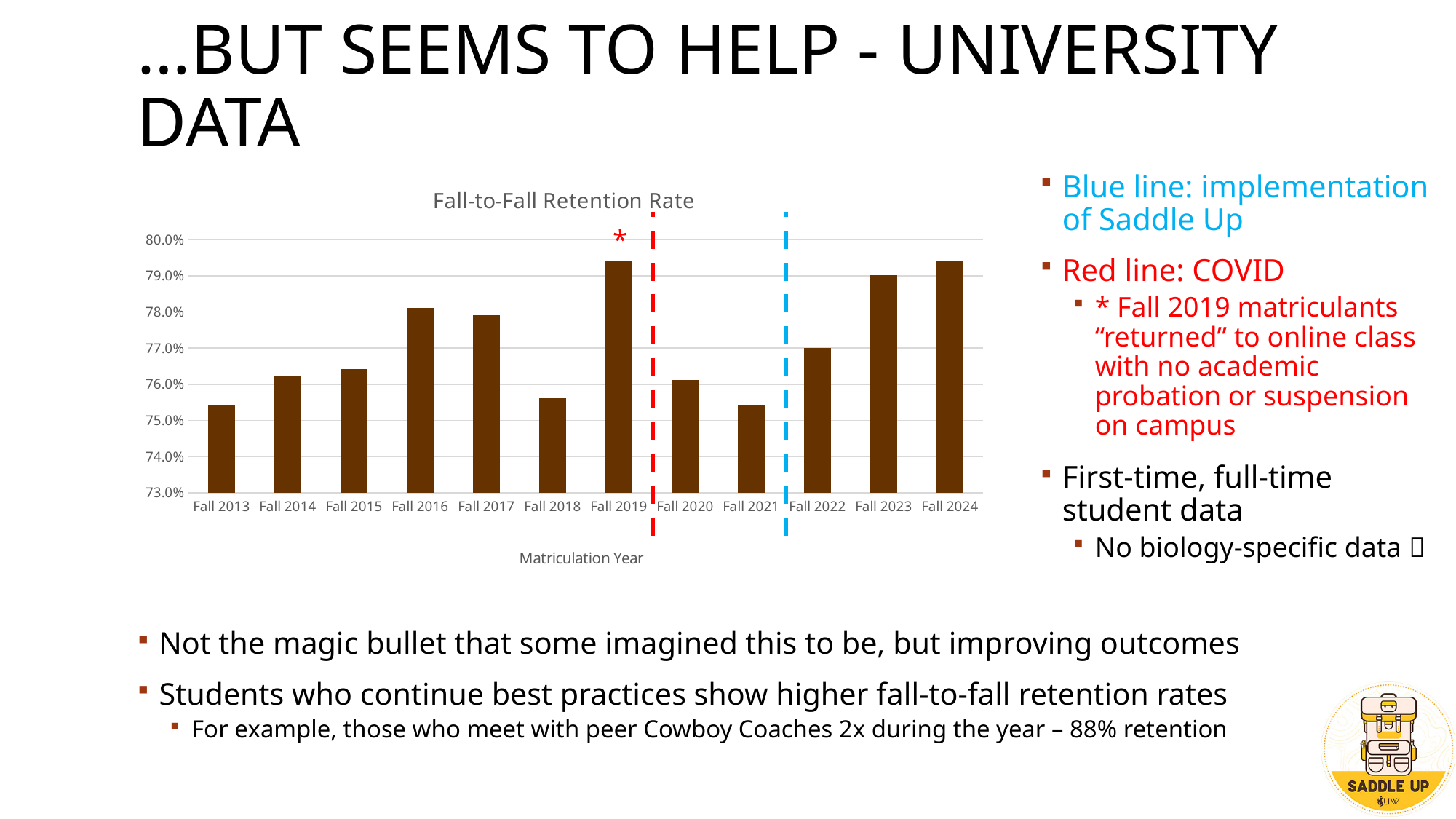
What is the label of the x axis of the chart? Matriculation Year What is the title of the chart? Fall-to-Fall Retention Rate Is the retention rate for Fall 2019 greater or less than 79.0%? greater Which has the higher retention rate, Fall 2020 or Fall 2023? Fall 2023 Is the retention rate for Fall 2023 greater or less than 78.0%? greater Which has the higher retention rate, Fall 2016 or Fall 2018? Fall 2016 How many matriculation years are plotted in the chart? 12 Is the retention rate for Fall 2013 greater or less than 76.0%? less What type of chart is shown on the slide? Bar chart Do the retention rates rise or fall from Fall 2021 to Fall 2024? Rise